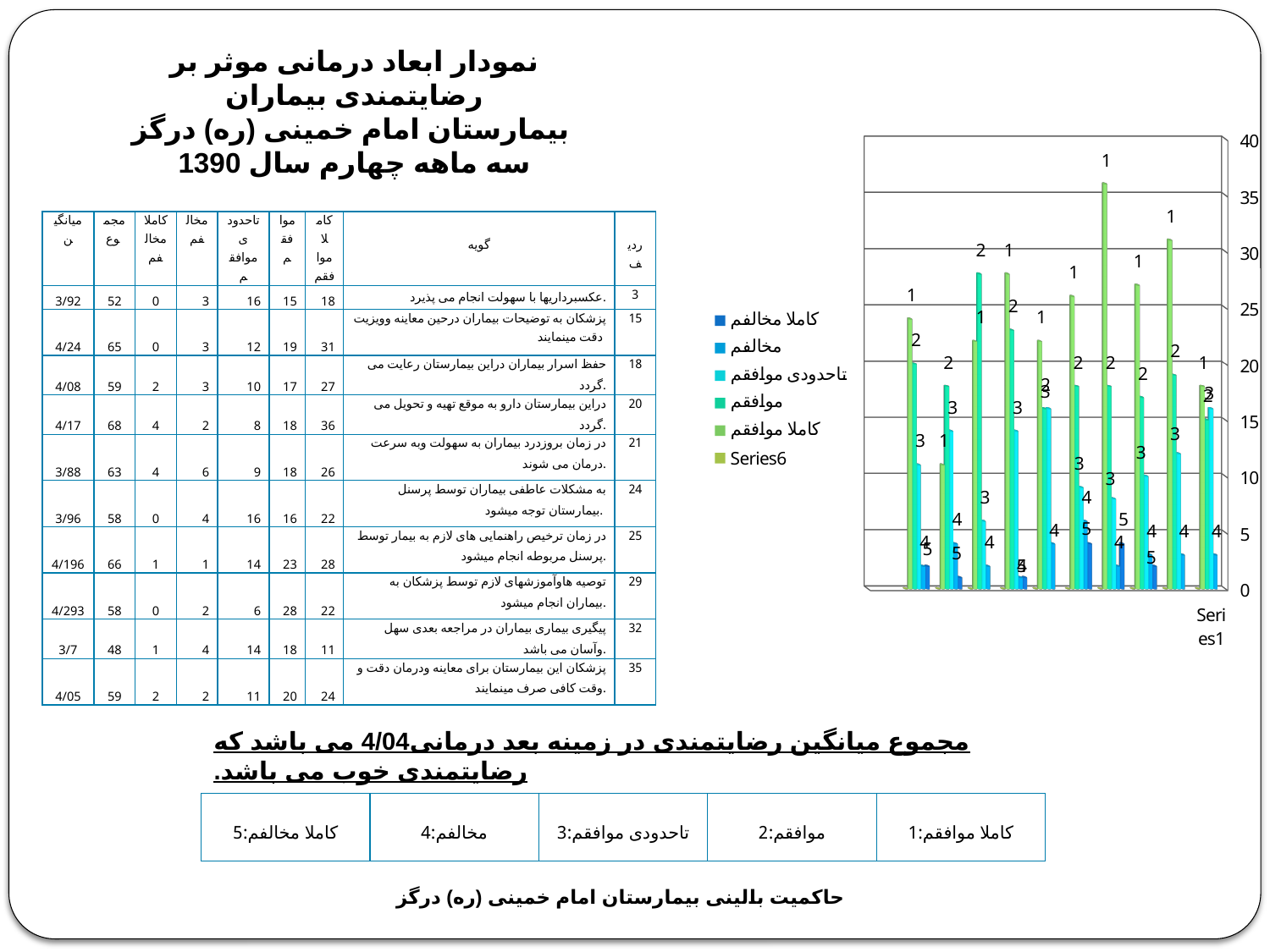
Is the tallest bar in the chart greater or less than 30? greater In the leftmost group of bars, which is taller: the کاملا موافقم bar or the تاحدودی موافقم bar? کاملا موافقم How many groups of bars are plotted along the x axis of the chart? 10 In the first (leftmost) group of bars, is the مخالفم bar greater or less than 10? less Which legend series does the tallest bar in the chart belong to? کاملا موافقم What is the last entry in the chart's legend? Series6 What is the highest value shown on the chart's vertical axis? 40 What label appears under the x axis of the chart? Series1 What kind of chart is shown on the right side of the slide? bar chart How many series does the chart's legend list? 6